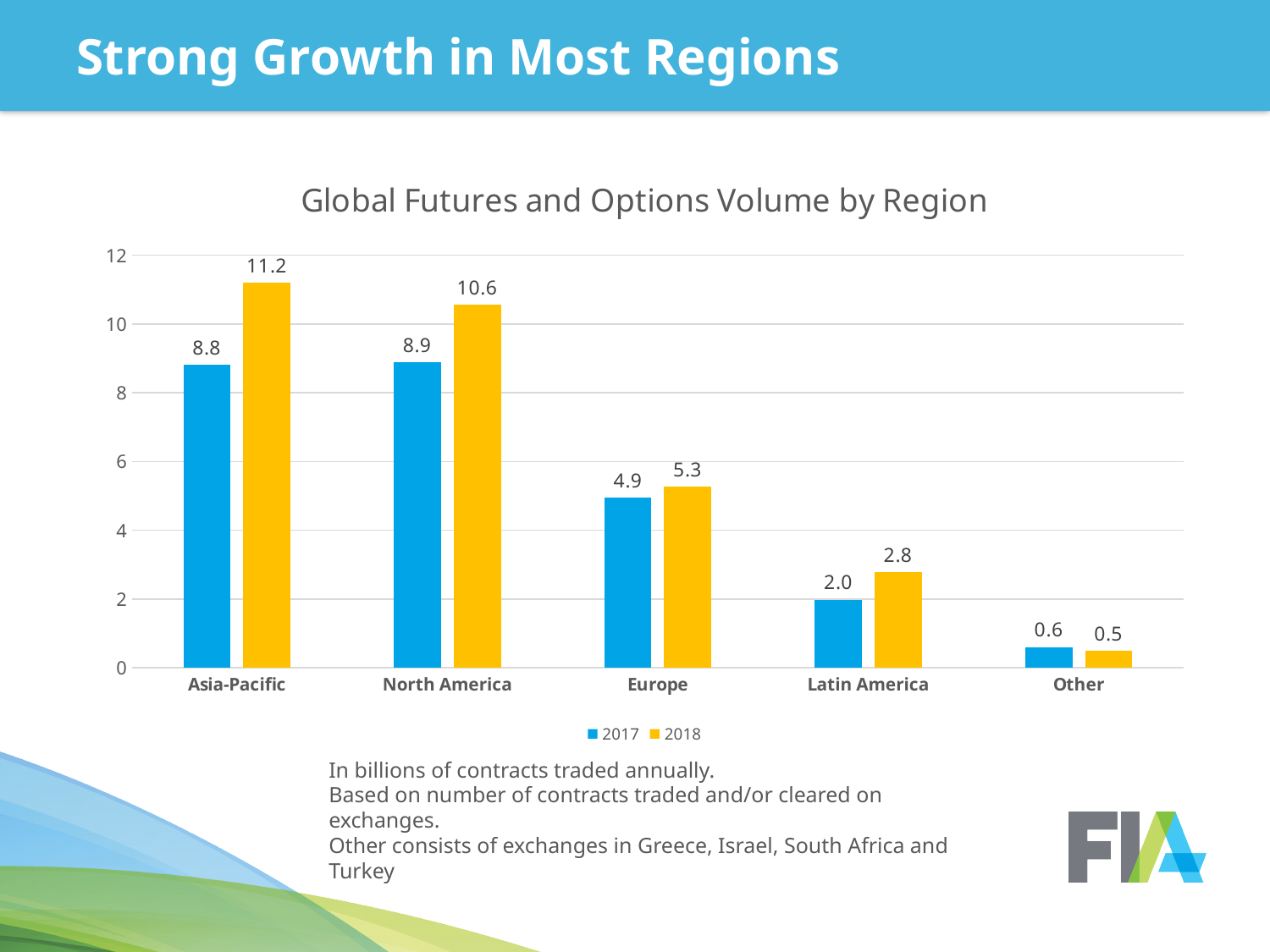
Which region has the highest 2018 value? Asia-Pacific What is the difference between the 2018 and 2017 values for Asia-Pacific? 2.4 Which is larger, the 2017 value for North America or the 2017 value for Asia-Pacific? North America What is the difference between the 2018 values for North America and Europe? 5.3 Which region has the lowest 2017 value? Other What is the 2017 value for Latin America? 2.0 How many regions are shown on the x axis? 5 How many series does the legend list? 2 What is the 2018 value for Asia-Pacific? 11.2 What is the 2018 value for Europe? 5.3 Is the 2018 value for Latin America greater or less than 2? greater What type of chart is shown? bar chart